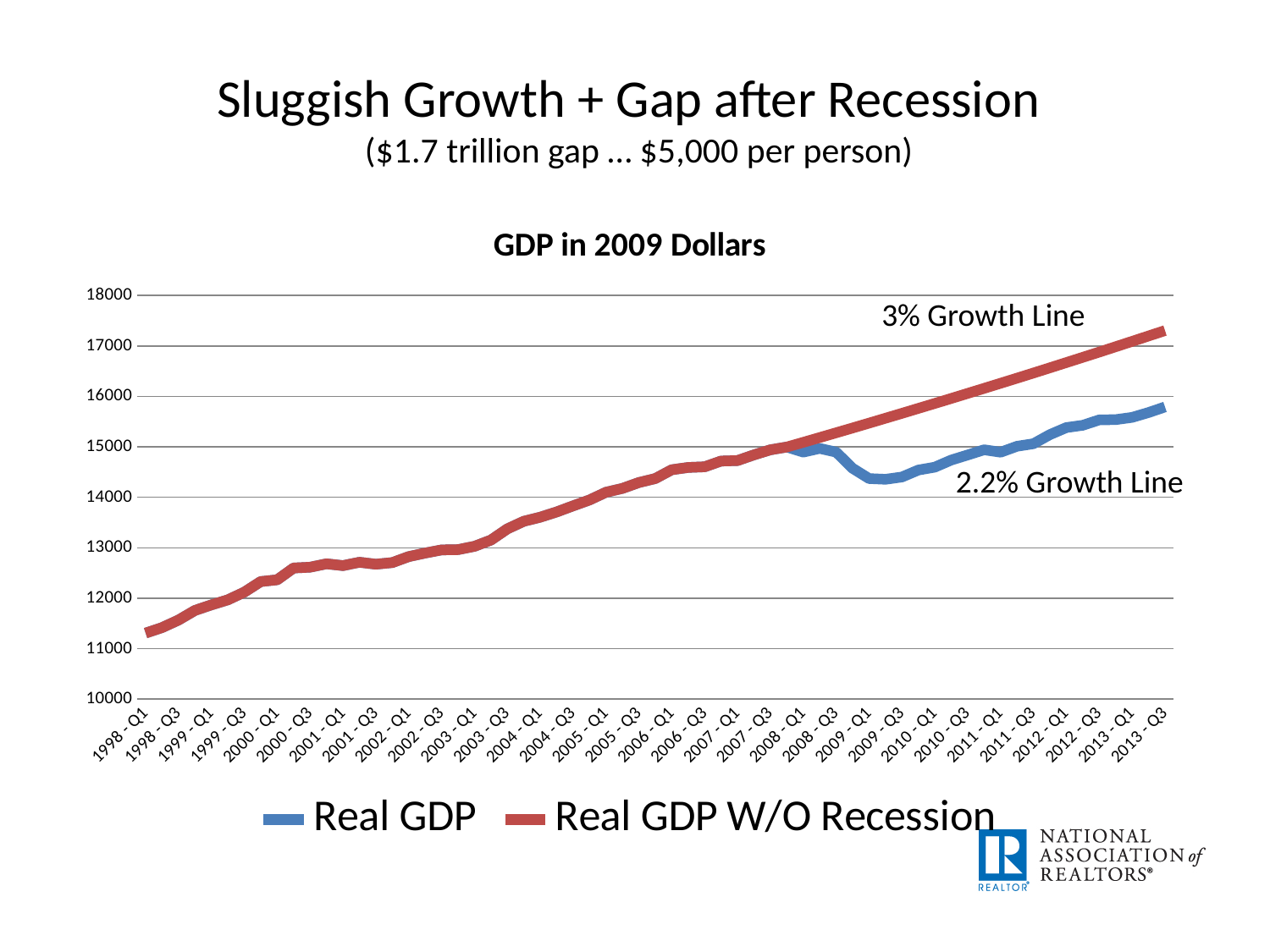
How many series does the legend list? 2 Is the value of Real GDP at 1998 - Q1 greater or less than 11000? greater Does the Real GDP W/O Recession line rise or fall from 1998 - Q1 to 2013 - Q3? Rises Which series reaches the highest value on the chart? Real GDP W/O Recession Is the value of Real GDP at 2009 - Q3 greater or less than 15000? less Is the value of Real GDP at 2013 - Q3 greater or less than 16000? less Which series is drawn in blue? Real GDP What is the title of the chart? GDP in 2009 Dollars At 2013 - Q3, which series has the higher value, Real GDP or Real GDP W/O Recession? Real GDP W/O Recession What kind of chart is shown on the slide? Line chart At which quarter is the Real GDP line at its lowest value? 1998 - Q1